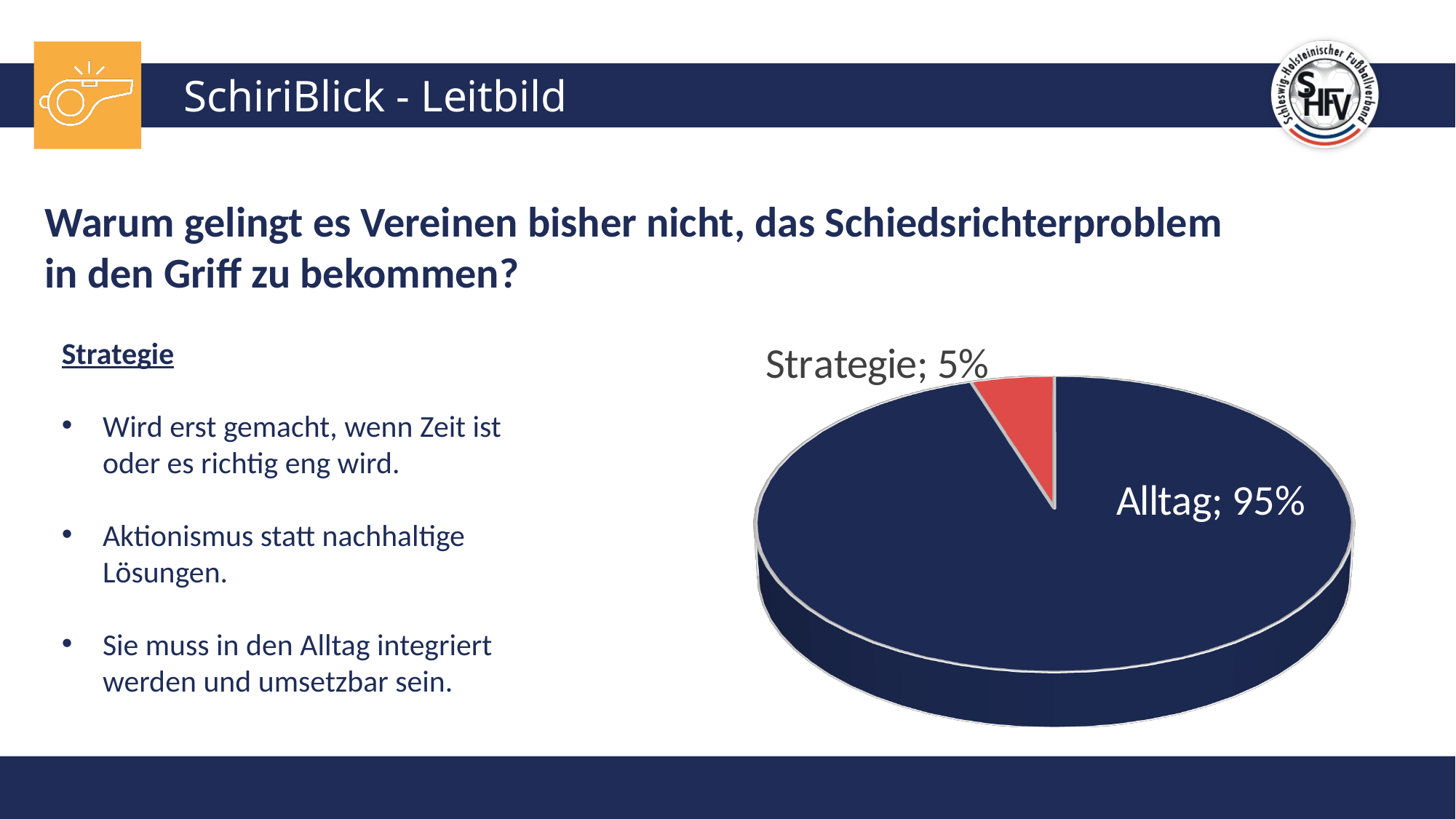
What share of the pie chart does Strategie represent? 5% Which slice of the pie chart is the smallest? Strategie What is the difference in percentage points between the Alltag and Strategie slices? 90 What share of the pie chart does Alltag represent? 95% What is the total of the two slices shown in the pie chart? 100% What colour is the Alltag slice in the pie chart? Dark blue What colour is the Strategie slice in the pie chart? Red Which is larger in the pie chart, Alltag or Strategie? Alltag What kind of chart is shown on the slide? Pie chart How many slices does the pie chart have? 2 Which slice of the pie chart is the largest? Alltag